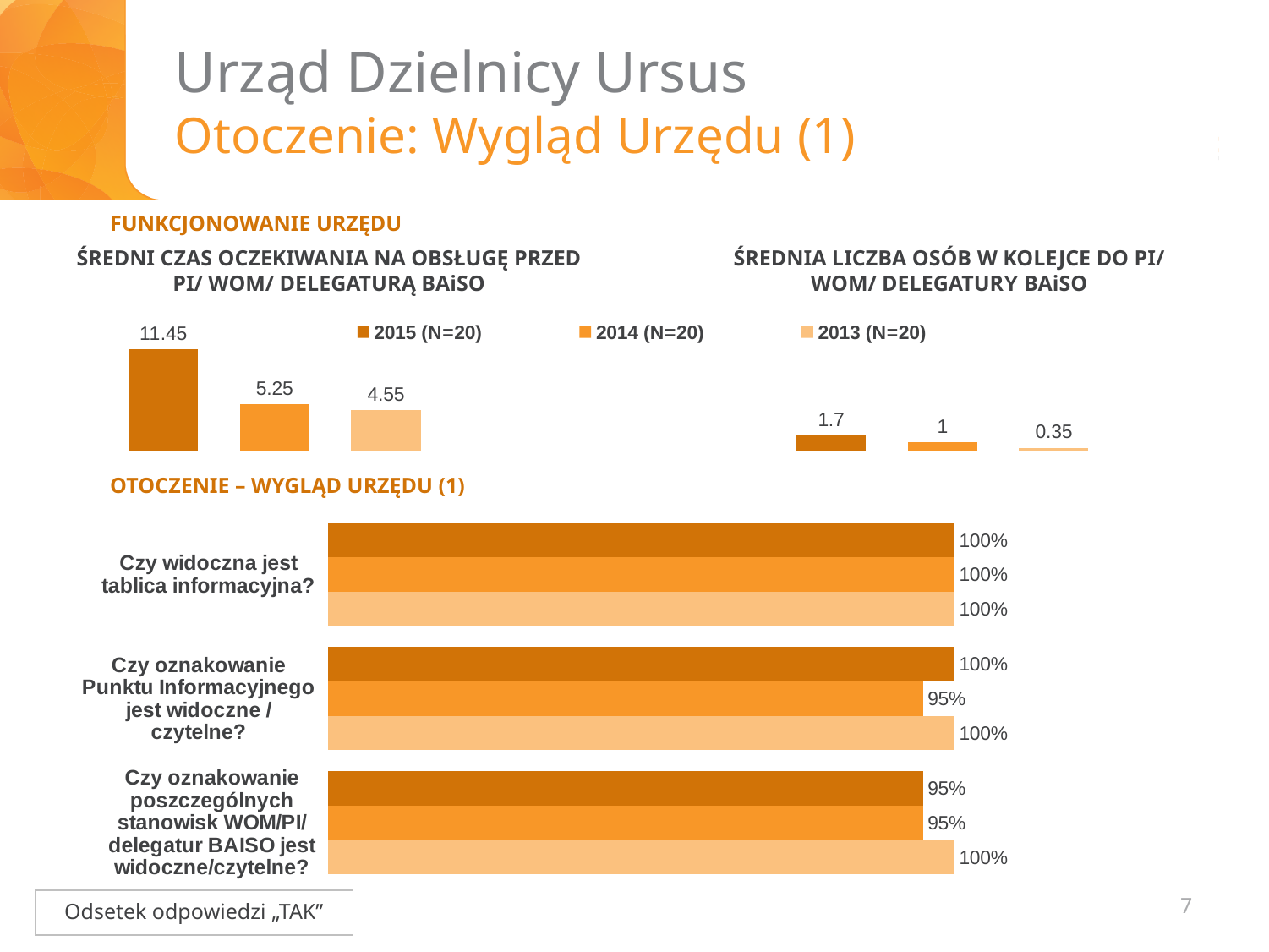
In the chart titled 'ŚREDNI CZAS OCZEKIWANIA NA OBSŁUGĘ PRZED PI/ WOM/ DELEGATURĄ BAiSO', what is the difference between the 2015 and 2014 values? 6.2 In the chart titled 'ŚREDNIA LICZBA OSÓB W KOLEJCE DO PI/ WOM/ DELEGATURY BAiSO', what is the value for 2014? 1 What type of chart is the chart titled 'OTOCZENIE – WYGLĄD URZĘDU (1)'? Bar chart In the chart titled 'ŚREDNIA LICZBA OSÓB W KOLEJCE DO PI/ WOM/ DELEGATURY BAiSO', what is the difference between the 2015 and 2013 values? 1.35 In the chart titled 'ŚREDNI CZAS OCZEKIWANIA NA OBSŁUGĘ PRZED PI/ WOM/ DELEGATURĄ BAiSO', which year has the highest value? 2015 In the chart titled 'ŚREDNIA LICZBA OSÓB W KOLEJCE DO PI/ WOM/ DELEGATURY BAiSO', which year has the lowest value? 2013 In the chart titled 'ŚREDNI CZAS OCZEKIWANIA NA OBSŁUGĘ PRZED PI/ WOM/ DELEGATURĄ BAiSO', what is the value for 2013? 4.55 In the chart titled 'OTOCZENIE – WYGLĄD URZĘDU (1)', what is the 2013 value for 'Czy oznakowanie poszczególnych stanowisk WOM/PI/ delegatur BAISO jest widoczne/czytelne?'? 100% In the chart titled 'OTOCZENIE – WYGLĄD URZĘDU (1)', how many question categories are shown? 3 How many series does the legend shared by the top charts list? 3 In the chart titled 'ŚREDNI CZAS OCZEKIWANIA NA OBSŁUGĘ PRZED PI/ WOM/ DELEGATURĄ BAiSO', what is the value for 2015? 11.45 In the chart titled 'OTOCZENIE – WYGLĄD URZĘDU (1)', what is the 2014 value for 'Czy oznakowanie Punktu Informacyjnego jest widoczne / czytelne?'? 95%